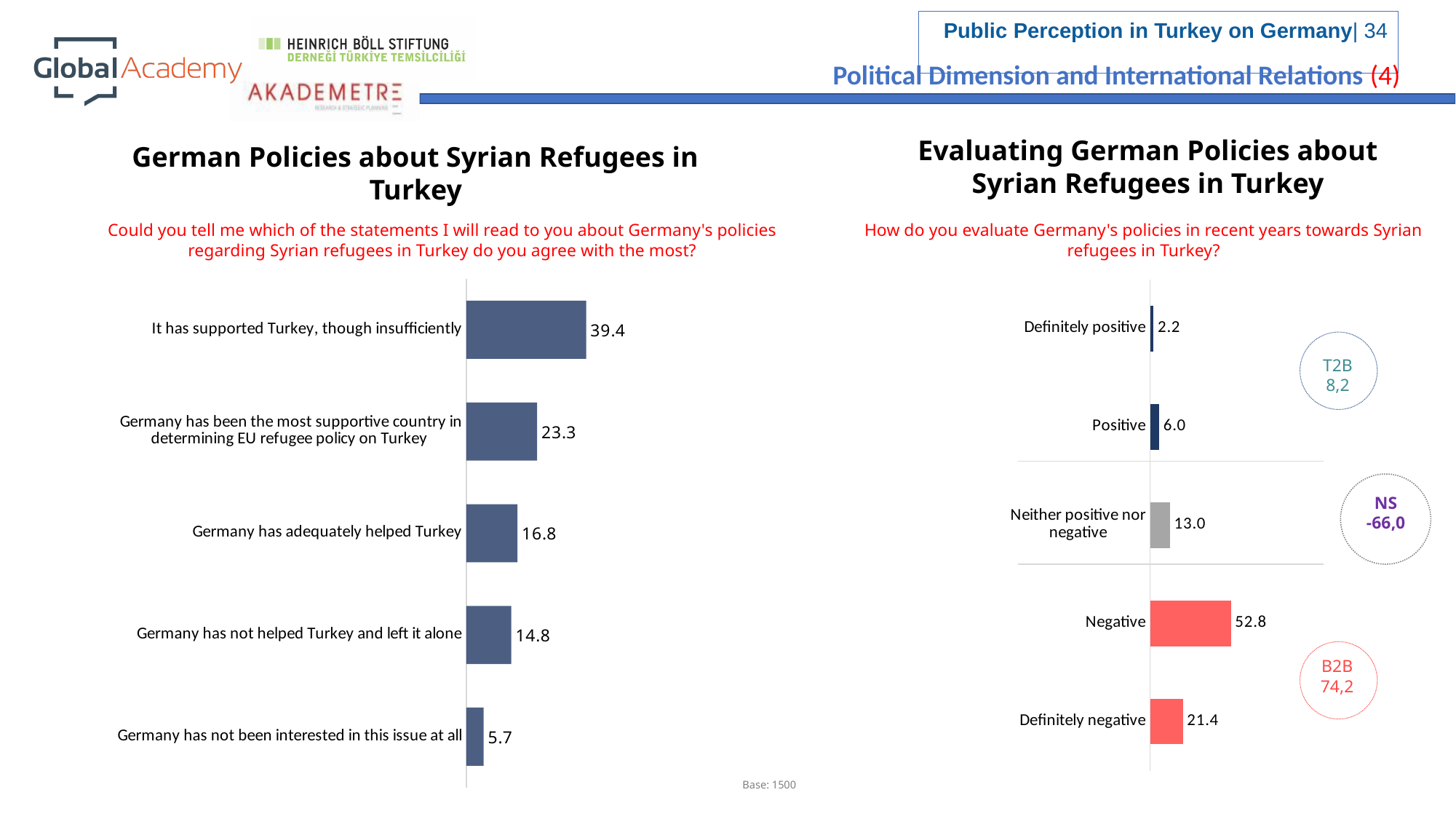
In the 'German Policies about Syrian Refugees in Turkey' chart, what is the difference between 'Germany has been the most supportive country in determining EU refugee policy on Turkey' and 'Germany has adequately helped Turkey'? 6.5 In the 'Evaluating German Policies about Syrian Refugees in Turkey' chart, what is the value for 'Negative'? 52.8 In the 'German Policies about Syrian Refugees in Turkey' chart, which is larger: 'Germany has adequately helped Turkey' or 'Germany has not helped Turkey and left it alone'? Germany has adequately helped Turkey In the 'German Policies about Syrian Refugees in Turkey' chart, how many statements are shown? 5 In the 'Evaluating German Policies about Syrian Refugees in Turkey' chart, which category has the lowest value? Definitely positive In the 'Evaluating German Policies about Syrian Refugees in Turkey' chart, what B2B value is shown in the circle? 74,2 In the 'German Policies about Syrian Refugees in Turkey' chart, which statement has the lowest value? Germany has not been interested in this issue at all In the 'Evaluating German Policies about Syrian Refugees in Turkey' chart, what is the difference between 'Negative' and 'Definitely negative'? 31.4 In the 'Evaluating German Policies about Syrian Refugees in Turkey' chart, which category has the highest value? Negative In the 'German Policies about Syrian Refugees in Turkey' chart, what is the value for 'It has supported Turkey, though insufficiently'? 39.4 In the 'Evaluating German Policies about Syrian Refugees in Turkey' chart, what is the value for 'Neither positive nor negative'? 13.0 What type of chart is the 'Evaluating German Policies about Syrian Refugees in Turkey' chart? Bar chart